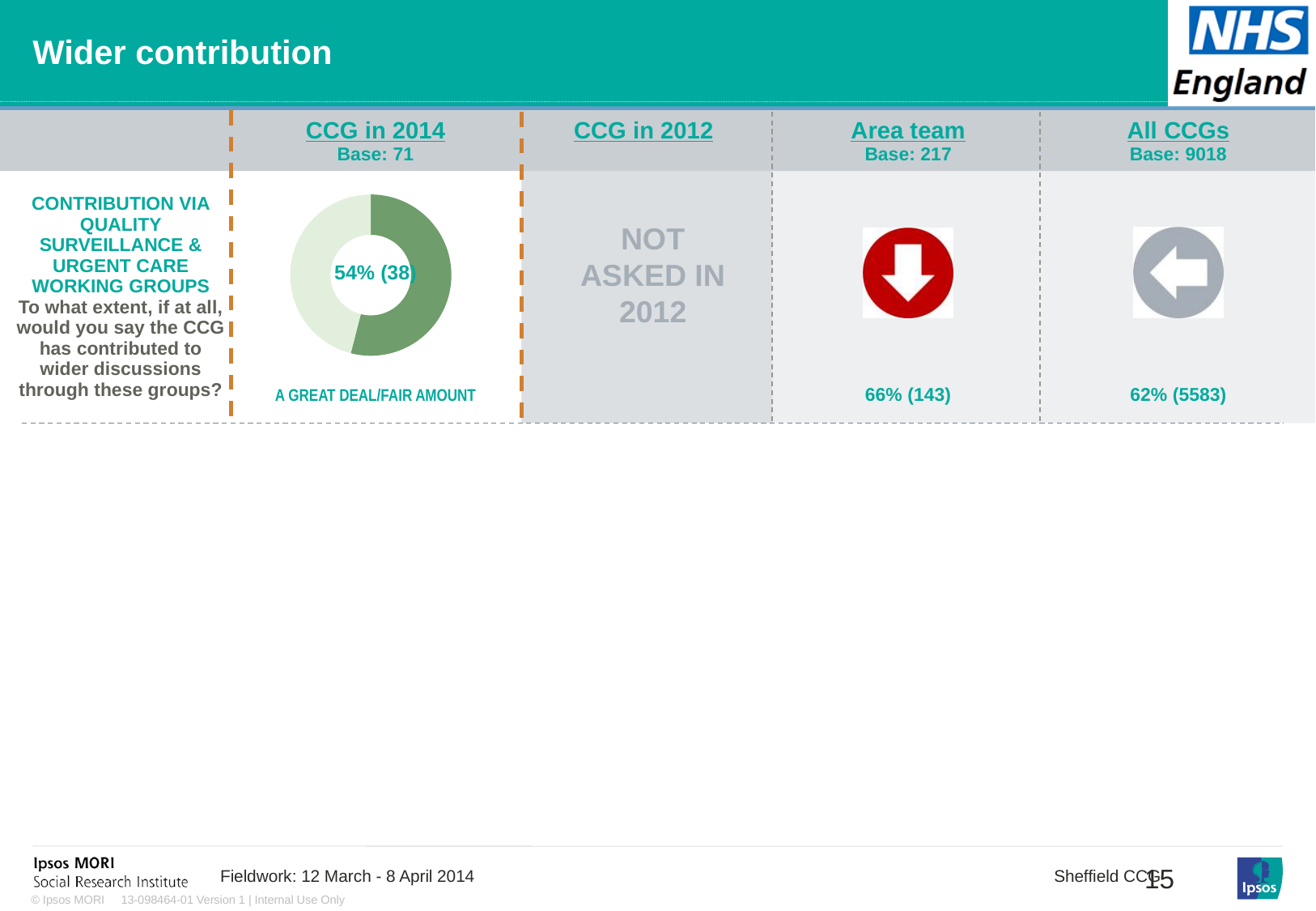
What does the CCG in 2012 column show instead of a chart? Not asked in 2012 How many segments does the doughnut chart have? 2 What is the base (number of respondents) for the CCG in 2014 doughnut chart? 71 What percentage is shown in the centre of the doughnut chart for CCG in 2014? 54% What kind of chart is shown in the CCG in 2014 column? Doughnut (pie) chart What share of the doughnut chart does the dark green segment represent? 54% What number of respondents is shown in brackets next to the 54% in the doughnut chart? 38 Which is larger: the CCG in 2014 doughnut value (54%) or the Area team value (66%)? Area team (66%) What is the difference between the All CCGs value (62%) and the CCG in 2014 doughnut value (54%)? 8 percentage points Is the value shown in the doughnut chart greater or less than 50%? greater What response category does the doughnut chart's 54% represent, according to the label beneath it? A great deal/fair amount